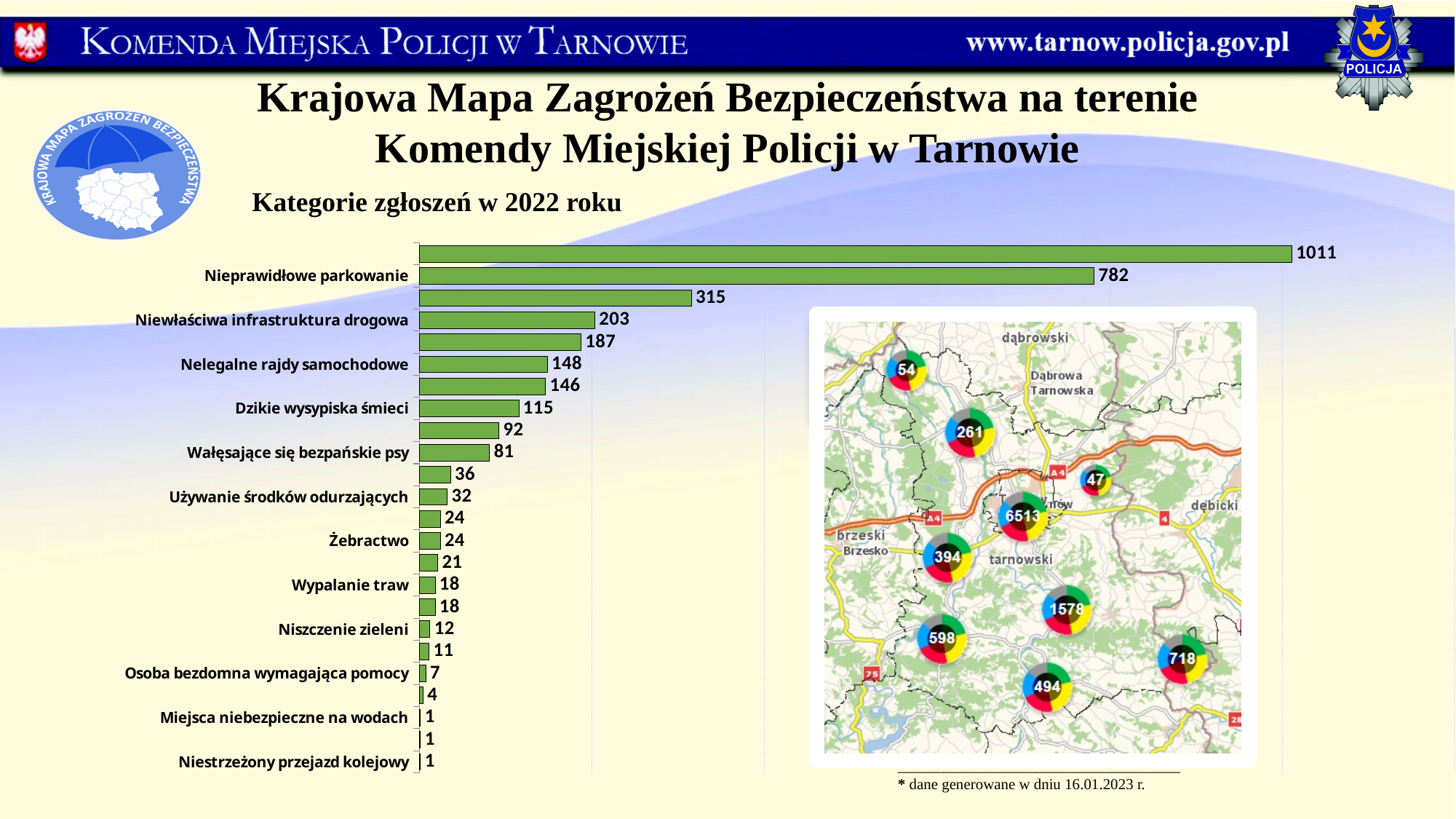
What is the largest value shown on the chart? 1011 What is the value for Osoba bezdomna wymagająca pomocy? 7 Which has a larger value, Nelegalne rajdy samochodowe or Używanie środków odurzających? Nelegalne rajdy samochodowe What is the value for Dzikie wysypiska śmieci? 115 What is the value for Niewłaściwa infrastruktura drogowa? 203 What is the title of the chart? Kategorie zgłoszeń w 2022 roku What type of chart is shown on the slide? bar chart What is the difference between the values for Nieprawidłowe parkowanie and Niewłaściwa infrastruktura drogowa? 579 Do the bar values increase or decrease from the top of the chart to the bottom? decrease How many bars are plotted on the chart? 24 What is the value for Nieprawidłowe parkowanie? 782 What is the value for Wałęsające się bezpańskie psy? 81